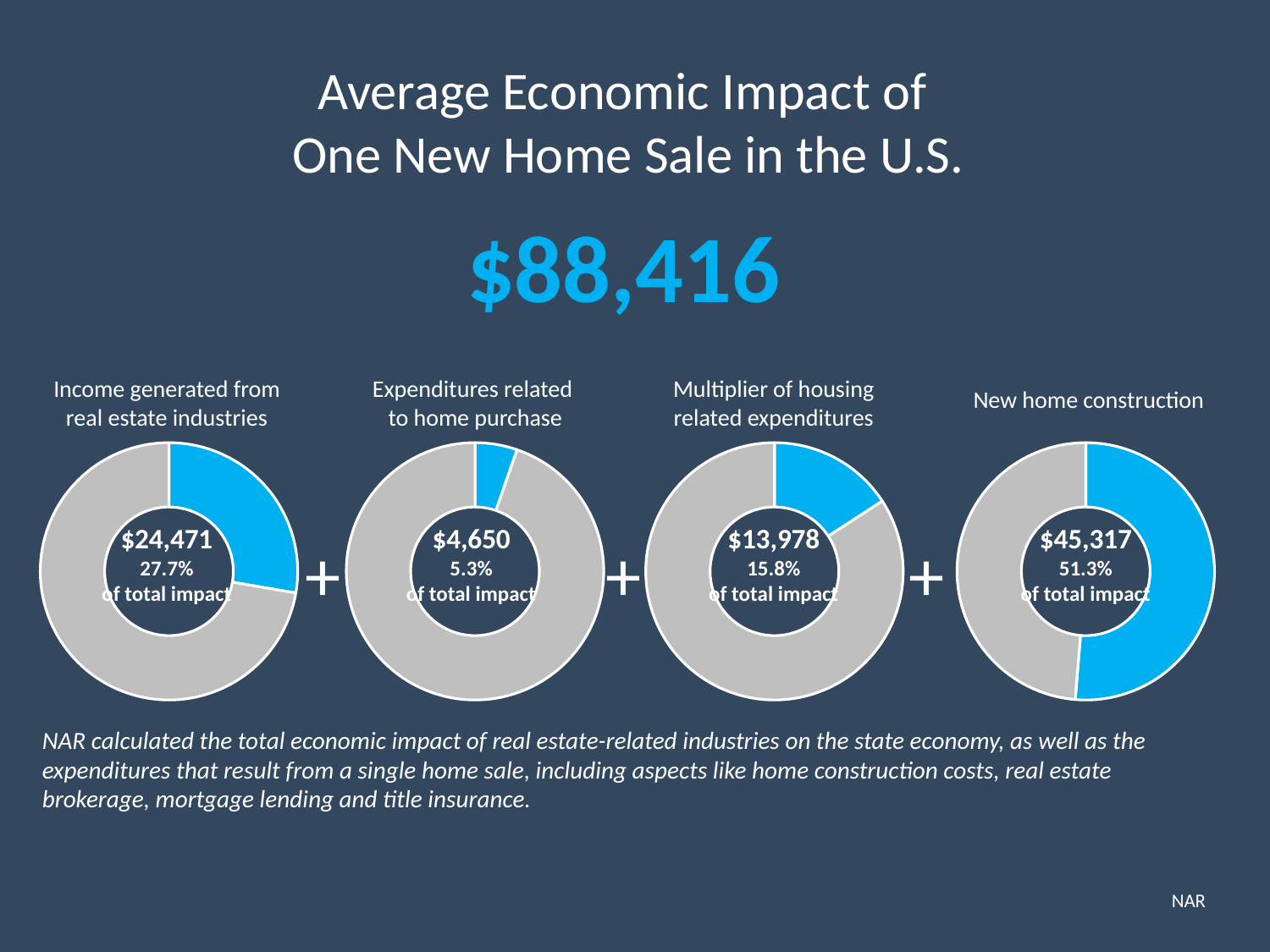
What is the difference between the 'Multiplier of housing related expenditures' value and the 'Expenditures related to home purchase' value? $9,328 Which of the four donut charts shows the smallest dollar value? Expenditures related to home purchase What share of total impact does the 'New home construction' donut chart show? 51.3% What is the dollar value shown in the 'Income generated from real estate industries' donut chart? $24,471 Which is larger: the 'Income generated from real estate industries' value or the 'Multiplier of housing related expenditures' value? Income generated from real estate industries Which of the four donut charts shows the largest dollar value? New home construction What is the dollar value shown in the 'Multiplier of housing related expenditures' donut chart? $13,978 How many donut charts are shown on the slide? 4 What is the difference between the 'New home construction' value and the 'Income generated from real estate industries' value? $20,846 What is the dollar value shown in the 'Expenditures related to home purchase' donut chart? $4,650 What share of total impact does the 'Multiplier of housing related expenditures' donut chart show? 15.8% What type of chart is used to show each component of the economic impact? Donut chart